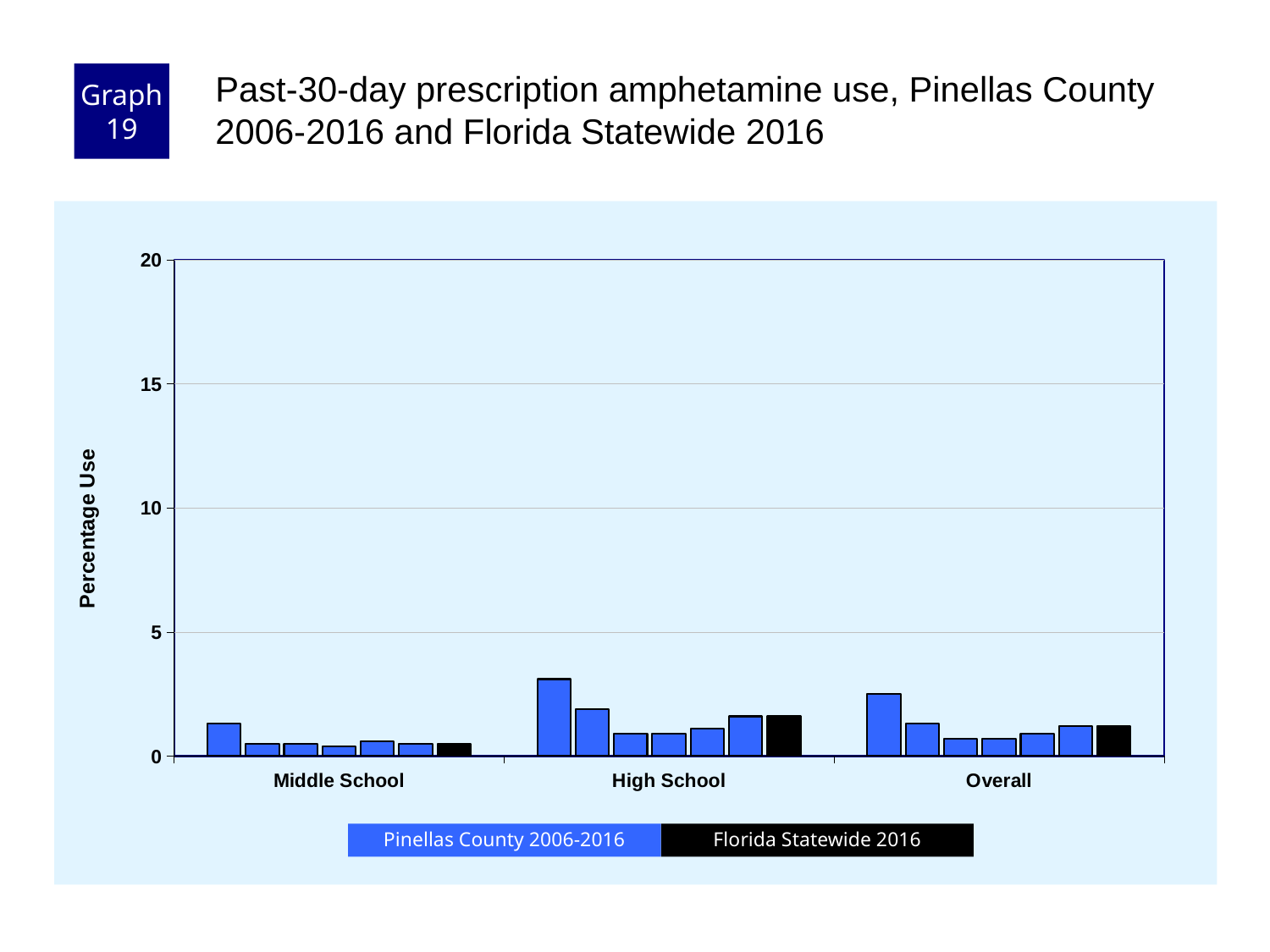
Which is larger: the first Pinellas County bar in the High School group or the first Pinellas County bar in the Middle School group? High School What kind of chart is shown on the slide? bar chart Is the tallest bar in the High School group greater or less than 5? less How many series does the legend list? 2 Is the Florida Statewide 2016 bar for Middle School greater or less than 5? less How many category groups are shown on the x axis? 3 Which is larger: the Florida Statewide 2016 bar for High School or the Florida Statewide 2016 bar for Middle School? High School Which category group contains the tallest bar? High School What is the label on the y axis? Percentage Use Within the Middle School group, is the first Pinellas County bar higher or lower than the last Pinellas County bar? higher Which category group has the lowest bars overall? Middle School Which colour represents Florida Statewide 2016 in the legend? black